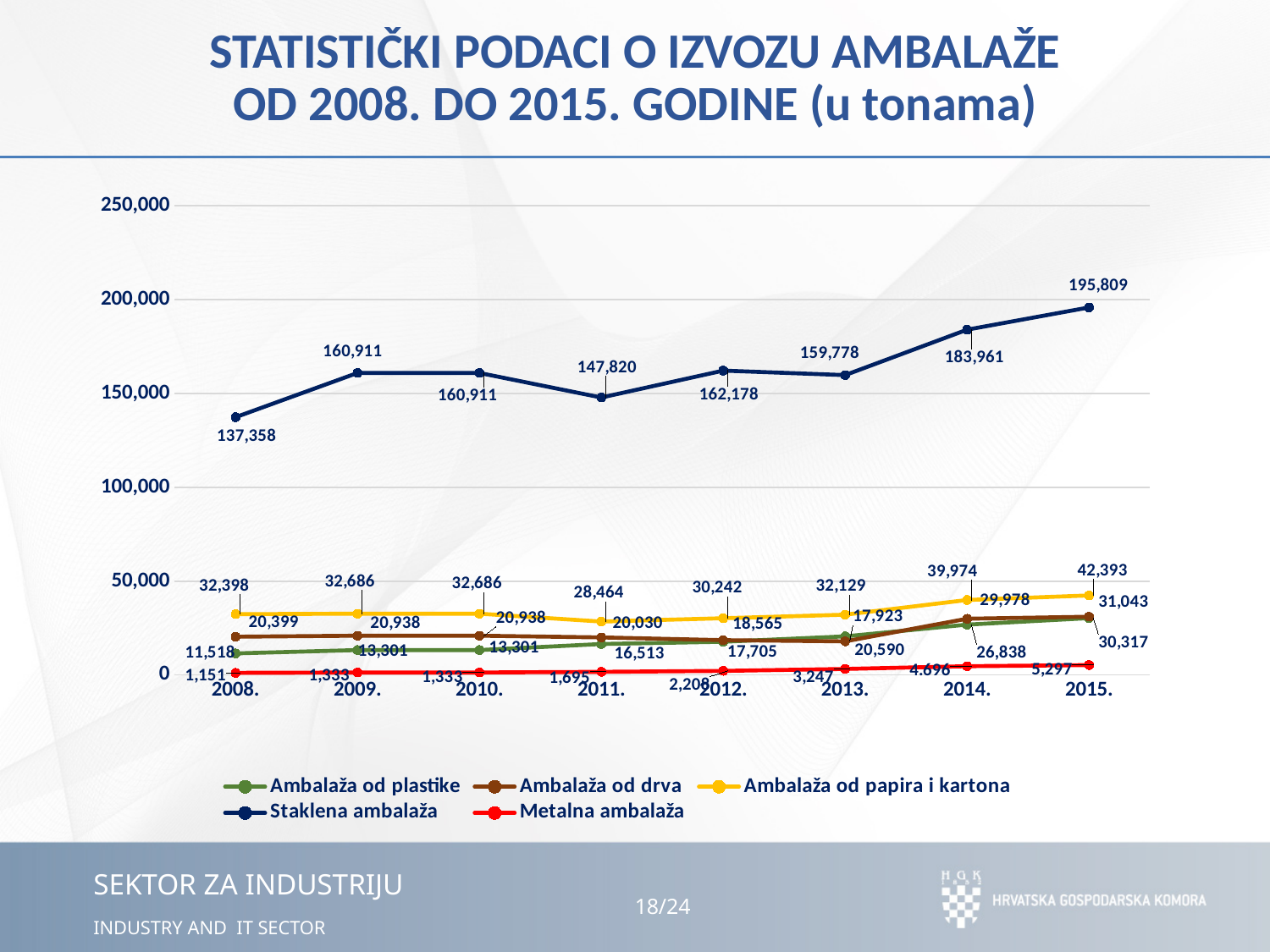
How many series does the legend list? 5 What is the value for Ambalaža od papira i kartona in 2015? 42,393 What is the value for Staklena ambalaža in 2008? 137,358 In which year is Staklena ambalaža at its highest? 2015. What is the value for Staklena ambalaža in 2015? 195,809 Does the value for Metalna ambalaža rise or fall from 2008 to 2015? rise What is the value for Metalna ambalaža in 2008? 1,151 How many years are plotted along the x axis? 8 Which is larger for Staklena ambalaža: the value in 2011 or in 2012? 2012 In which year is Staklena ambalaža at its lowest? 2008. By how much did Staklena ambalaža increase from 2008 to 2015? 58,451 What kind of chart is shown on the slide? line chart